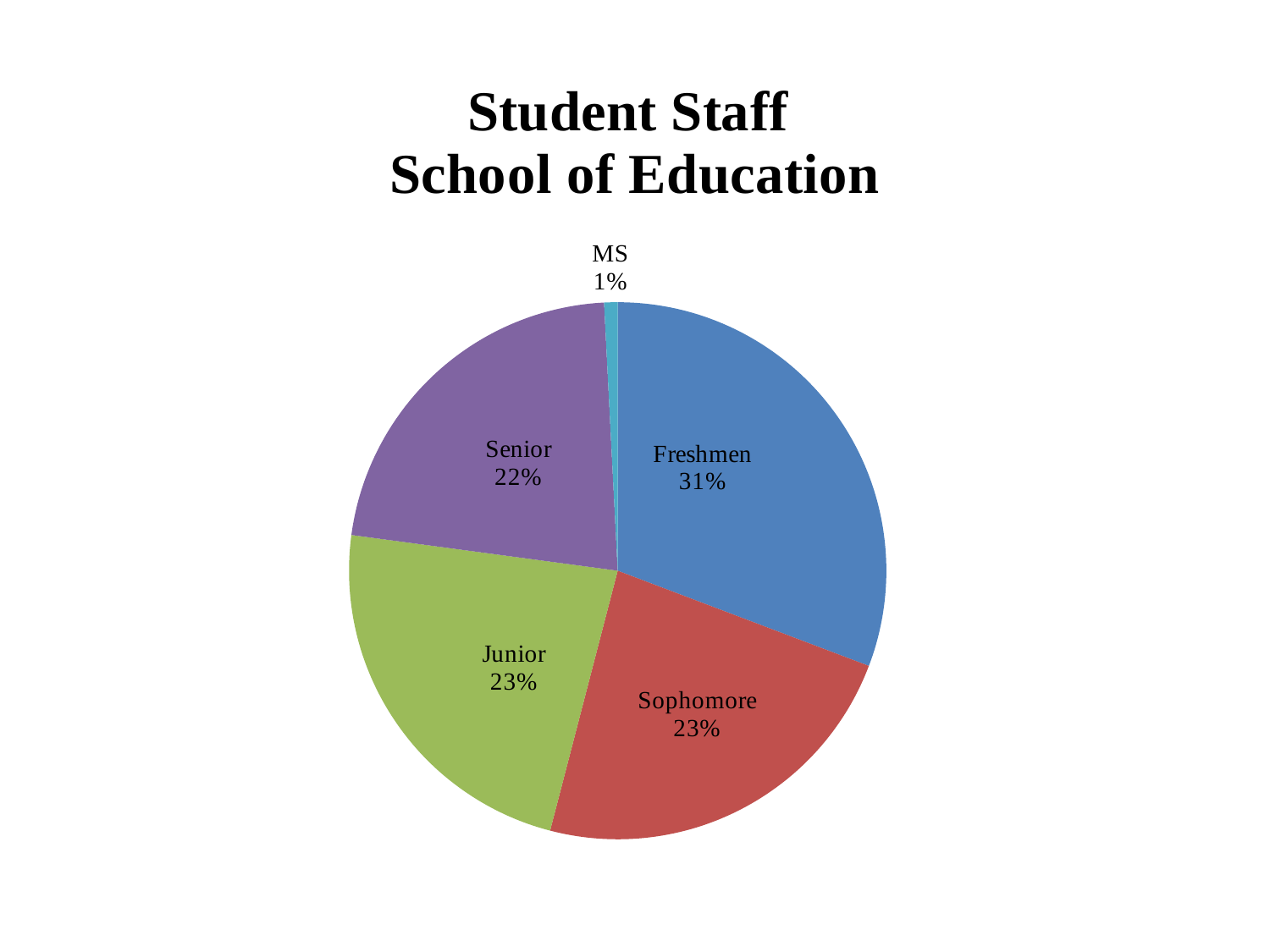
What is the value shown for Junior? 23% What kind of chart is shown on the slide? Pie chart What colour is the Sophomore slice? Red What is the title of the chart? Student Staff School of Education Which category has the smallest slice of the pie? MS What is the difference between the Freshmen share and the Senior share? 9% What is the value shown for MS? 1% Which is larger, the Freshmen share or the Sophomore share? Freshmen What is the value shown for Senior? 22% Which category has the largest slice of the pie? Freshmen What share of the pie does Freshmen represent? 31% How many categories are shown in the pie chart? 5